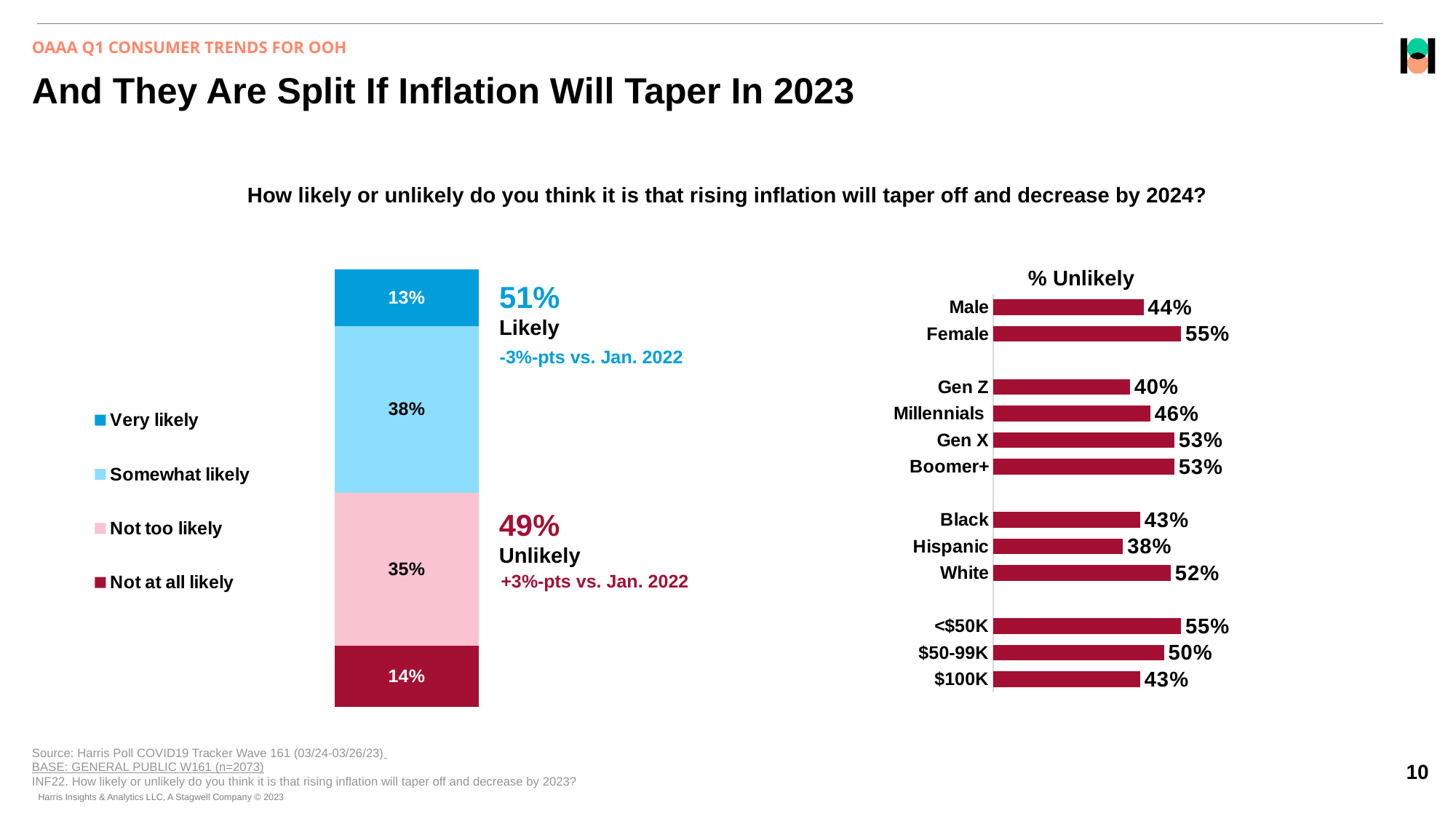
In the % Unlikely chart, what is the value for Hispanic? 38% In the % Unlikely chart, how many categories are plotted? 12 In the stacked bar chart on the left, what percentage is shown for Not at all likely? 14% In the stacked bar chart on the left, what percentage is shown for Somewhat likely? 38% In the % Unlikely chart, what is the value for Millennials? 46% In the % Unlikely chart, what is the difference between Female and Male? 11% In the stacked bar chart on the left, which segment has the largest value? Somewhat likely What type of chart is the % Unlikely chart? Bar chart In the stacked bar chart on the left, how many entries does the legend list? 4 In the stacked bar chart on the left, what is the difference between the Somewhat likely and Not too likely segments? 3% In the % Unlikely chart, which is larger, the value for Gen Z or the value for Gen X? Gen X In the % Unlikely chart, which category has the lowest value? Hispanic